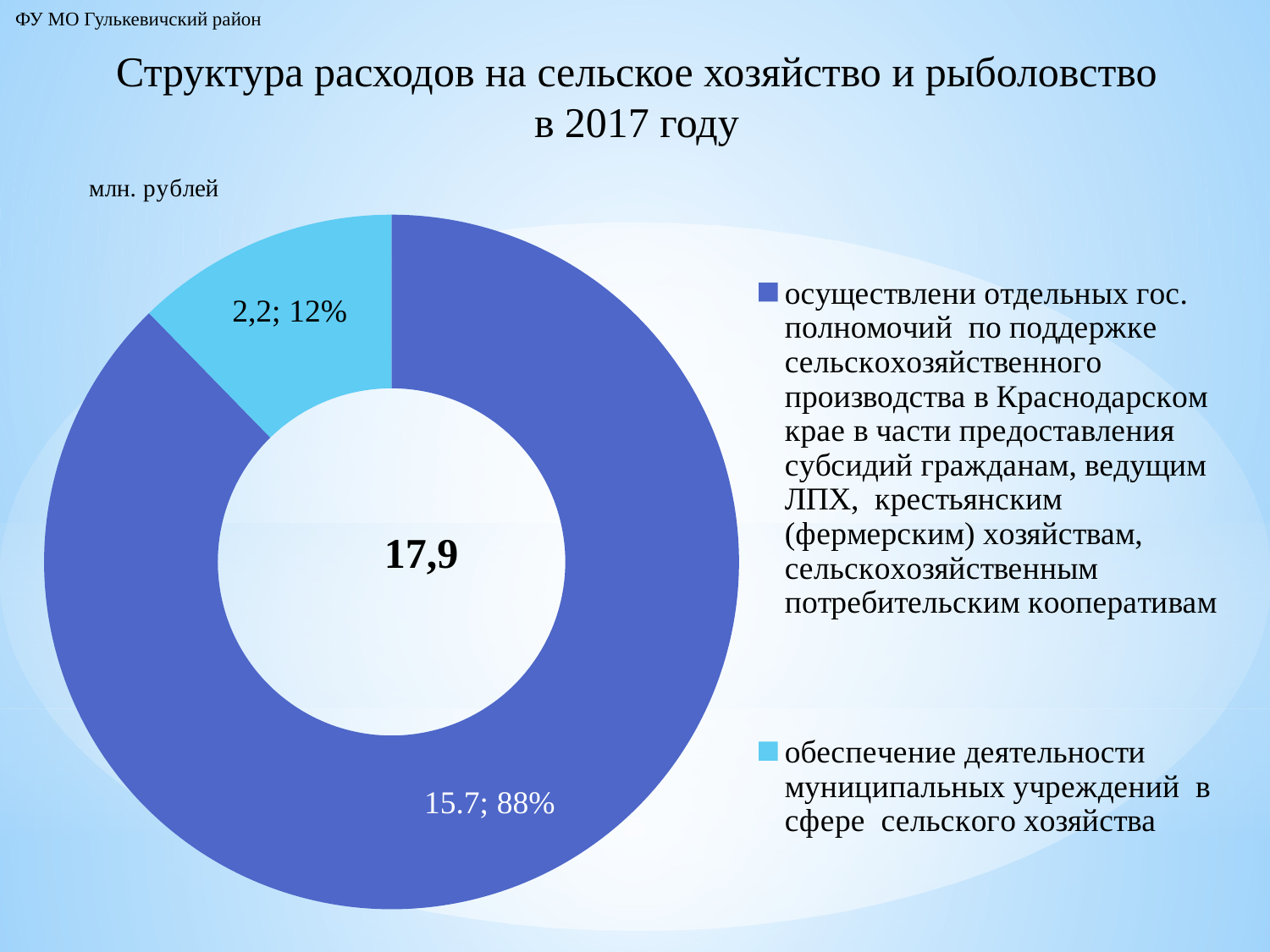
How many slices does the chart have? 2 Which is larger: the value for осуществление отдельных гос. полномочий or the value for обеспечение деятельности муниципальных учреждений? осуществление отдельных гос. полномочий What kind of chart is shown on the slide? Doughnut (pie) chart What share of the total does the slice on осуществление отдельных гос. полномочий по поддержке сельскохозяйственного производства account for? 88% What share of the total does "обеспечение деятельности муниципальных учреждений в сфере сельского хозяйства" account for? 12% What total value is shown in the centre of the chart? 17,9 Which category has the smallest slice? обеспечение деятельности муниципальных учреждений в сфере сельского хозяйства What is the value (in млн. рублей) for "обеспечение деятельности муниципальных учреждений в сфере сельского хозяйства"? 2,2 What is the value (in млн. рублей) for the slice on осуществление отдельных гос. полномочий по поддержке сельскохозяйственного производства? 15.7 Which category has the largest slice? осуществление отдельных гос. полномочий по поддержке сельскохозяйственного производства How many entries does the legend list? 2 In what units are the chart values given? млн. рублей